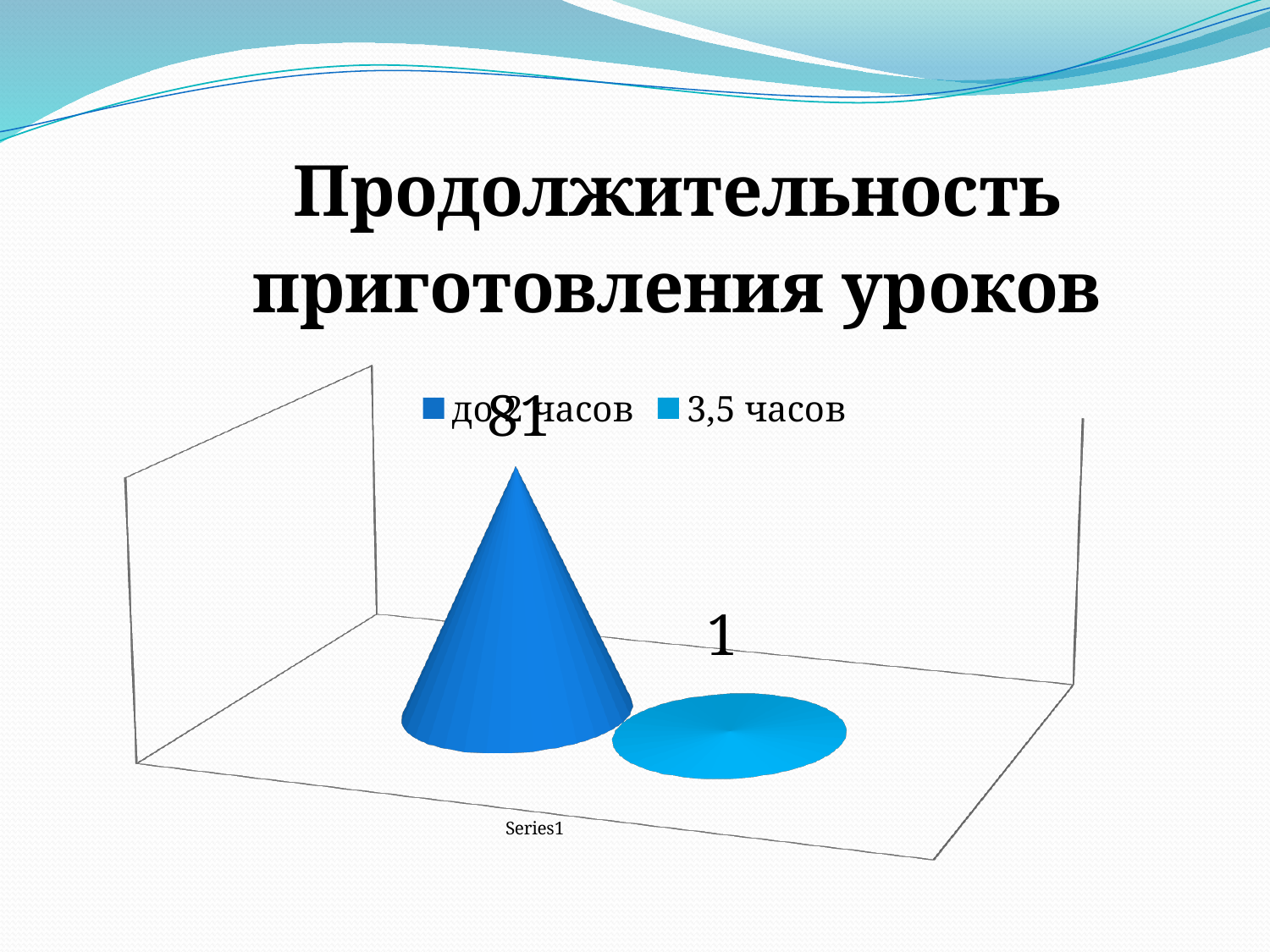
What is the value for the series "3,5 часов"? 1 What is the title of the slide above the chart? Продолжительность приготовления уроков How many series does the legend list? 2 What kind of chart is shown on the slide? bar chart Which series has the highest value? до 2 часов What is the total of the two plotted values? 82 What is the difference between the values for "до 2 часов" and "3,5 часов"? 80 How many categories are shown on the category axis? 1 What is the label shown on the category axis? Series1 What is the value for the series "до 2 часов"? 81 Which series has the lowest value? 3,5 часов Which is larger: the value for "до 2 часов" or the value for "3,5 часов"? до 2 часов